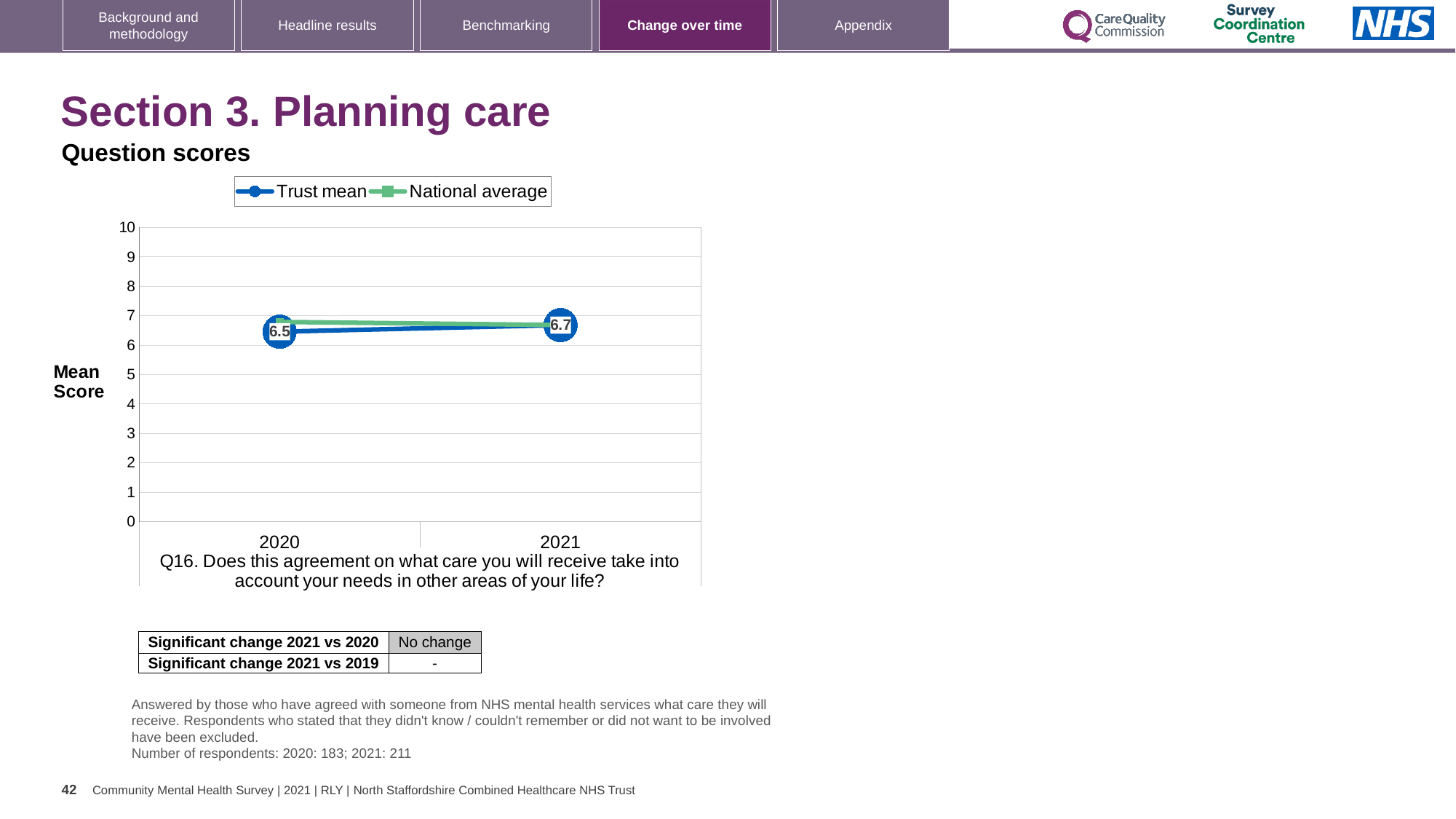
Is the National average for 2020 greater or less than 5? greater What kind of chart is shown on the slide? line chart Which year has the lowest Trust mean score? 2020 Which year has the higher Trust mean score, 2020 or 2021? 2021 Is the Trust mean for 2021 greater or less than 8? less What is the Trust mean score for 2020? 6.5 How many series does the legend list? 2 By how much did the Trust mean score change from 2020 to 2021? 0.2 How many years are plotted on the x axis? 2 Does the Trust mean score rise or fall from 2020 to 2021? rise What are the two series named in the legend? Trust mean and National average What is the Trust mean score for 2021? 6.7